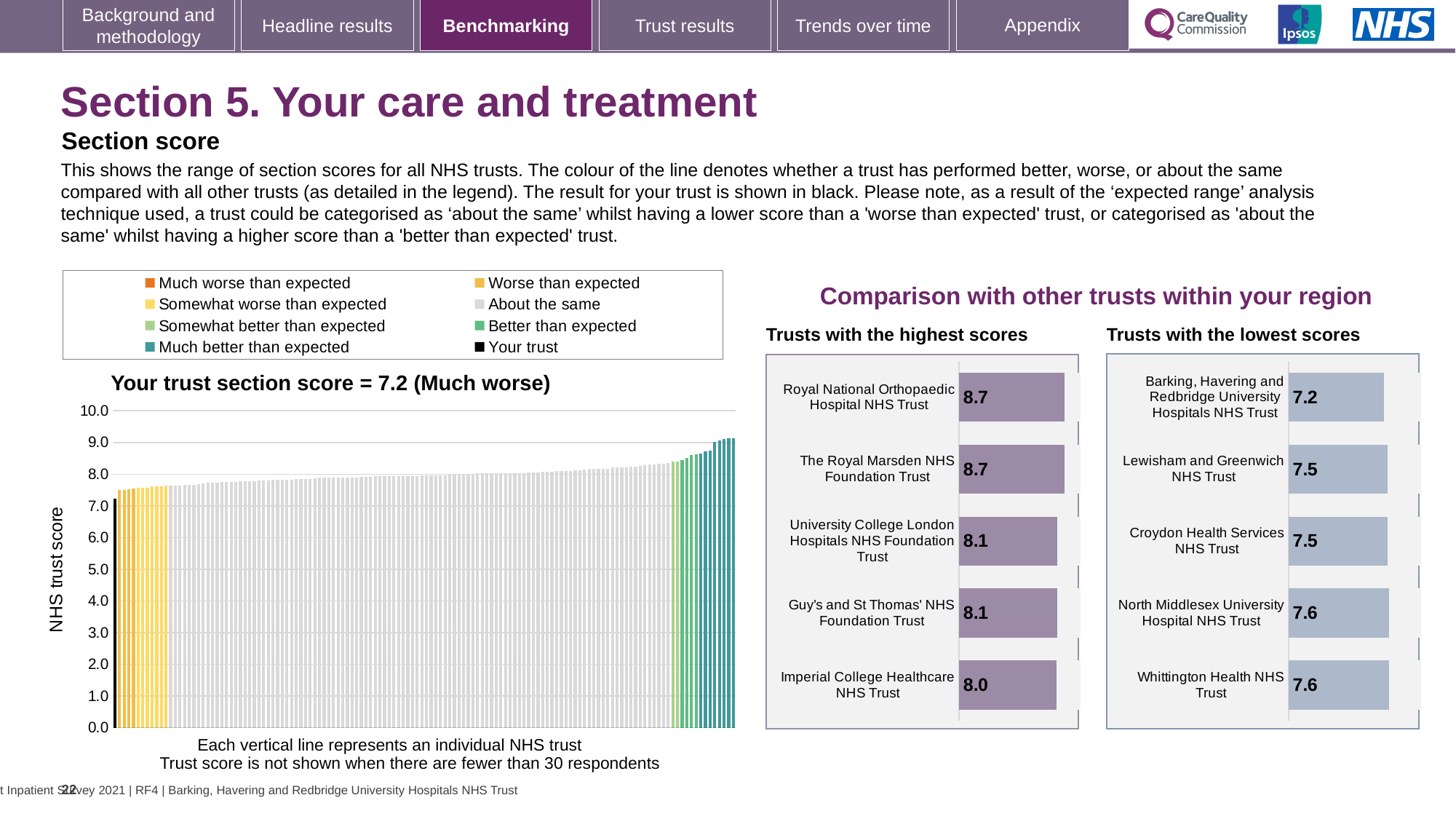
How many entries does the legend above the left chart list? 8 In the 'Trusts with the highest scores' chart, what is the difference between the scores of Royal National Orthopaedic Hospital NHS Trust and Imperial College Healthcare NHS Trust? 0.7 In the 'Trusts with the lowest scores' chart, which has the larger score: Whittington Health NHS Trust or Barking, Havering and Redbridge University Hospitals NHS Trust? Whittington Health NHS Trust How many trusts are shown in the 'Trusts with the highest scores' chart? 5 In the 'Trusts with the highest scores' chart, what is the score for Imperial College Healthcare NHS Trust? 8.0 In the left chart, do the trust scores rise or fall from left to right along the x axis? rise In the left chart, is the value for your trust (the black bar) greater or less than 7.0? greater According to the title of the left chart, what is your trust's section score? 7.2 In the 'Trusts with the lowest scores' chart, which trust has the lowest score? Barking, Havering and Redbridge University Hospitals NHS Trust In the 'Trusts with the lowest scores' chart, what is the score for Lewisham and Greenwich NHS Trust? 7.5 What kind of chart is the 'Your trust section score' chart on the left? bar chart In the 'Trusts with the highest scores' chart, which trust has the lowest score? Imperial College Healthcare NHS Trust